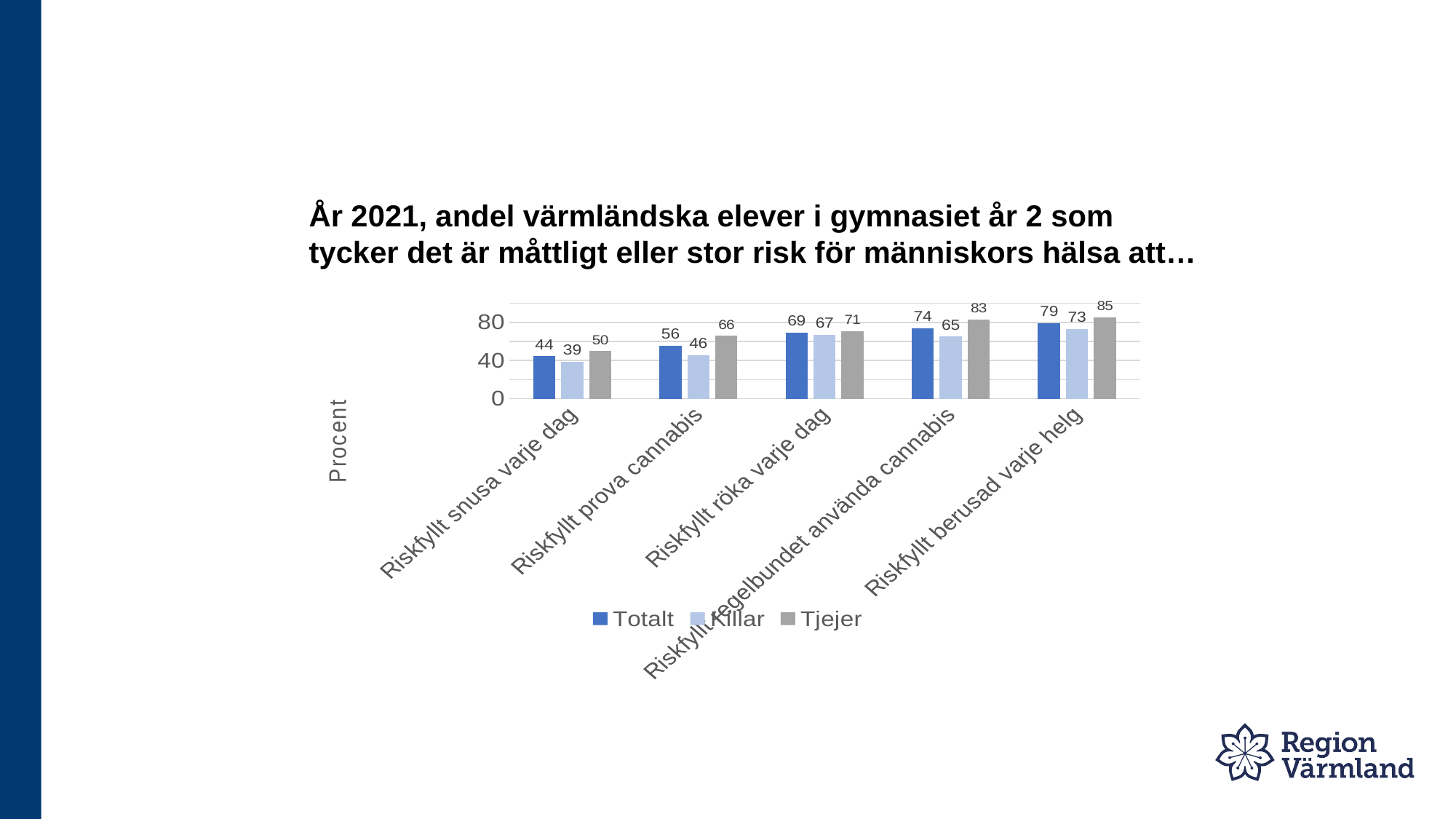
How many series does the legend list? 3 What is the label of the vertical axis? Procent What is the Totalt value for "Riskfyllt snusa varje dag"? 44 What kind of chart is shown on the slide? bar chart How many categories are shown on the x axis? 5 Which category has the highest Tjejer value? Riskfyllt berusad varje helg What is the Killar value for "Riskfyllt regelbundet använda cannabis"? 65 Is the Tjejer value for "Riskfyllt berusad varje helg" greater or less than 80? greater Which is larger for "Riskfyllt prova cannabis": the Totalt value or the Killar value? Totalt Which category has the lowest Killar value? Riskfyllt snusa varje dag What is the difference between the Tjejer and Killar values for "Riskfyllt regelbundet använda cannabis"? 18 What is the Tjejer value for "Riskfyllt prova cannabis"? 66